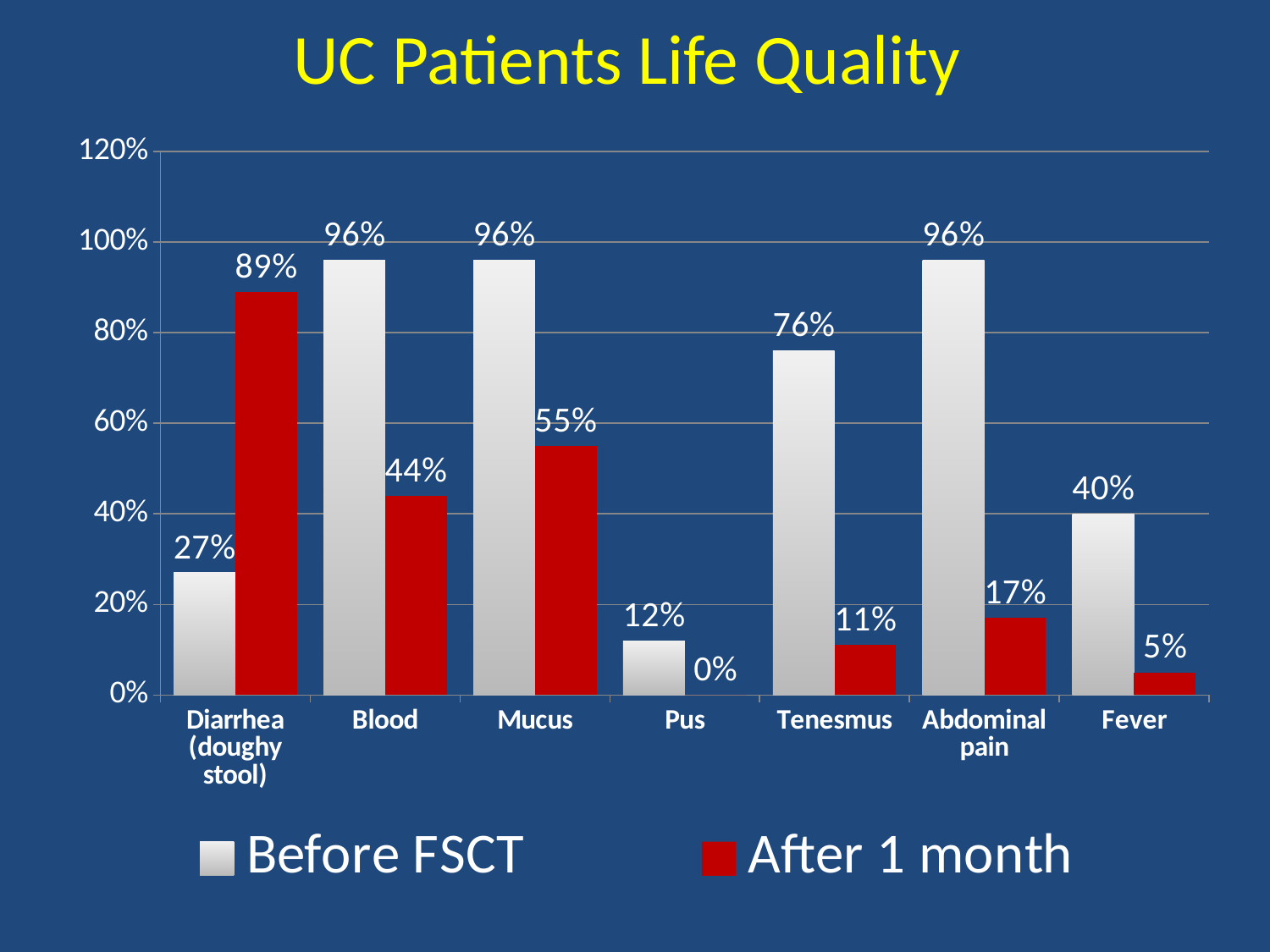
What is the value for Blood in the Before FSCT series? 96% How many categories are shown on the x axis? 7 What is the value for Tenesmus in the Before FSCT series? 76% Which category has the lowest value in the Before FSCT series? Pus For Diarrhea (doughy stool), which is larger: the Before FSCT value or the After 1 month value? After 1 month What kind of chart is shown on the slide? Bar chart What is the value for Mucus in the After 1 month series? 55% How many series does the legend list? 2 What is the title of the chart? UC Patients Life Quality Which category has the highest value in the After 1 month series? Diarrhea (doughy stool) What is the difference between the Before FSCT and After 1 month values for Abdominal pain? 79% What is the value for Pus in the After 1 month series? 0%